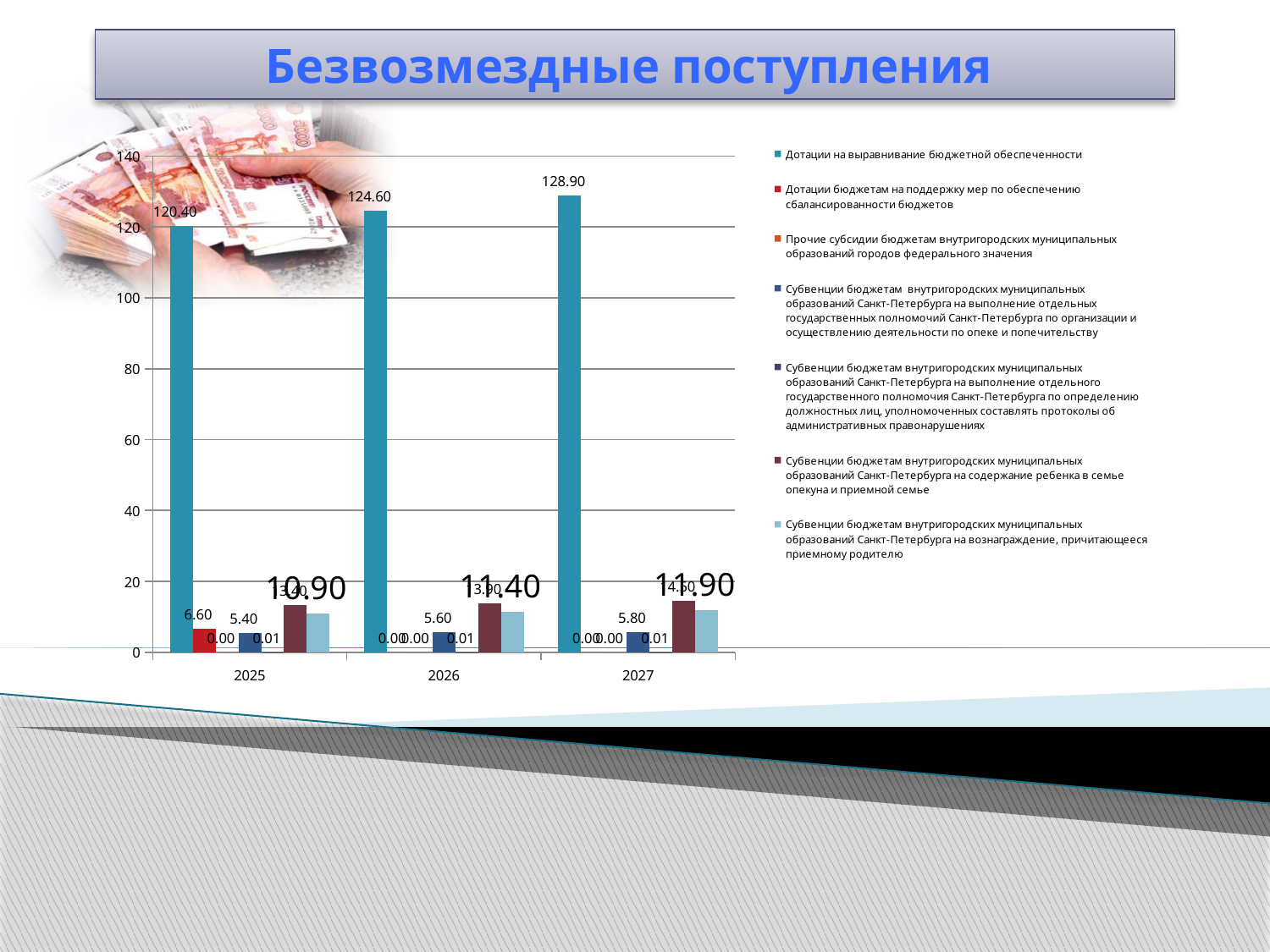
What is the value of 'Дотации на выравнивание бюджетной обеспеченности' for 2027? 128.90 How many series does the legend list? 7 What is the value of 'Субвенции бюджетам внутригородских муниципальных образований Санкт-Петербурга на вознаграждение, причитающееся приемному родителю' for 2026? 11.40 What is the value of 'Дотации бюджетам на поддержку мер по обеспечению сбалансированности бюджетов' for 2025? 6.60 What is the difference between the 'Дотации на выравнивание бюджетной обеспеченности' values for 2027 and 2025? 8.50 In which year is 'Дотации на выравнивание бюджетной обеспеченности' highest? 2027 Which is larger: 'Дотации на выравнивание бюджетной обеспеченности' in 2026 or in 2025? 2026 In which year is 'Дотации на выравнивание бюджетной обеспеченности' lowest? 2025 Is the value of 'Дотации на выравнивание бюджетной обеспеченности' for 2026 greater or less than 120? greater How many years are shown on the x axis? 3 What kind of chart is shown on the slide? Bar chart What is the value of 'Дотации на выравнивание бюджетной обеспеченности' for 2025? 120.40